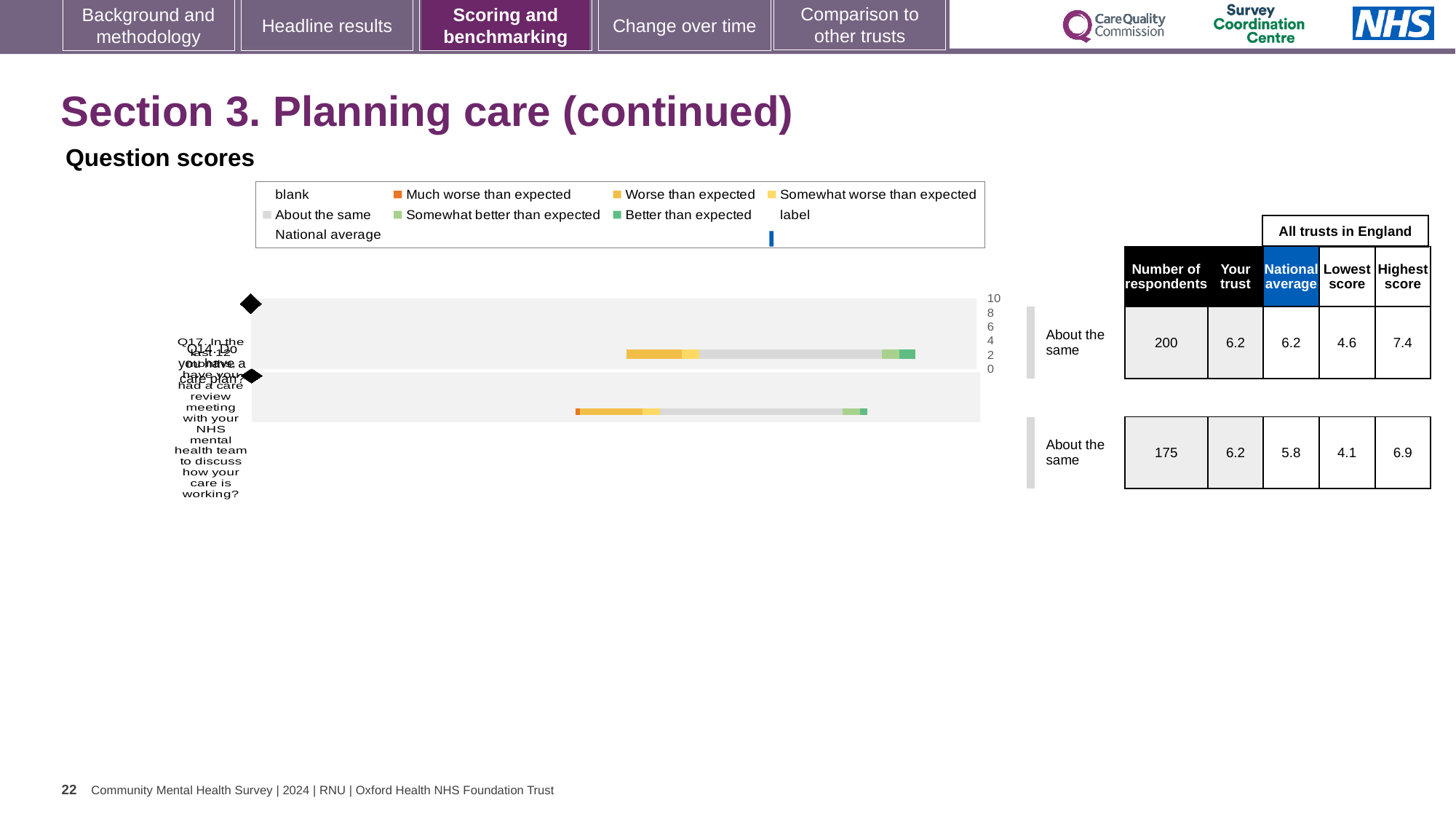
What benchmark category is shown next to both bars in the chart? About the same How many question rows (bars) are plotted in the chart? 2 For the bottom row (Q17), which is larger: the 'Your trust' score or the national average? Your trust What is the national average for the bottom row (Q17)? 5.8 Which colour in the legend represents 'Much worse than expected'? orange For the top row (Q14), what is the difference between the highest score and the lowest score? 2.8 What is the number of respondents for the top row (Q14) in the table beside the chart? 200 How many more respondents answered the top row (Q14) than the bottom row (Q17)? 25 What is the 'Your trust' score for the top row (Q14)? 6.2 What kind of chart is shown under 'Question scores'? bar chart What is the lowest score among all trusts in England for the bottom row (Q17)? 4.1 What is the highest score among all trusts in England for the top row (Q14)? 7.4